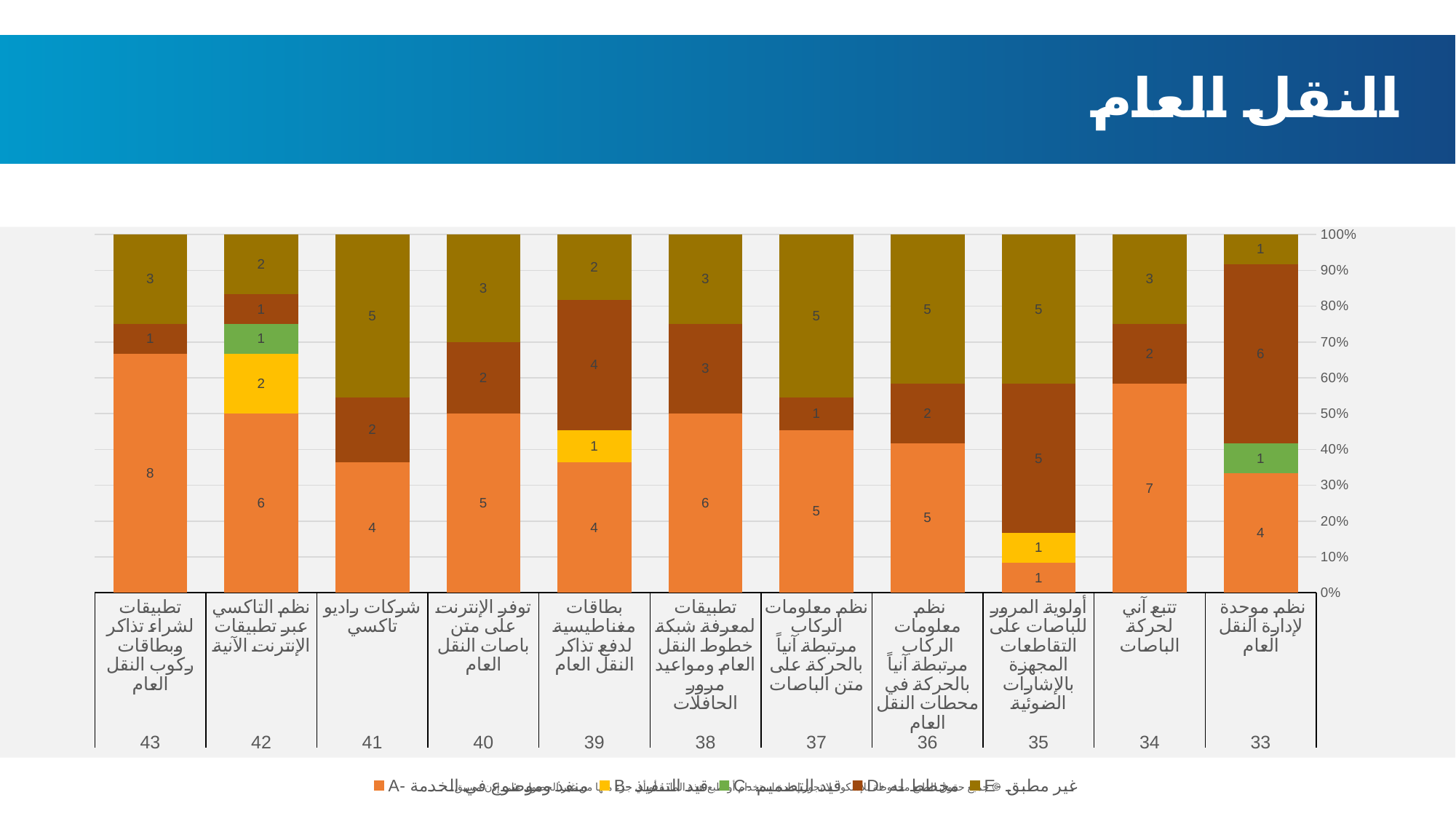
What is the difference between the orange (A) values for category 43 and category 35? 7 What is the total of all segments in the bar for category 43 (تطبيقات لشراء تذاكر وبطاقات ركوب النقل العام)? 12 How many categories are plotted along the x axis of the chart? 11 Which has the larger orange (A) value: category 34 (تتبع آني لحركة الباصات) or category 42 (نظم التاكسي عبر تطبيقات الإنترنت الآنية)? 34 (تتبع آني لحركة الباصات) Which category has the largest orange (A) segment? 43 (تطبيقات لشراء تذاكر وبطاقات ركوب النقل العام) What kind of chart is shown on the slide? Stacked bar chart How many series does the legend list? 5 What is the value of the brown (D) segment for category 33 (نظم موحدة لإدارة النقل العام)? 6 What is the value of the yellow (B) segment for category 42 (نظم التاكسي عبر تطبيقات الإنترنت الآنية)? 2 Is the top of the orange (A) segment for category 35 greater or less than 10% on the axis? less What is the value of the orange (A) segment for category 43 (تطبيقات لشراء تذاكر وبطاقات ركوب النقل العام)? 8 Which category has the smallest orange (A) segment? 35 (أولوية المرور للباصات على التقاطعات المجهزة بالإشارات الضوئية)